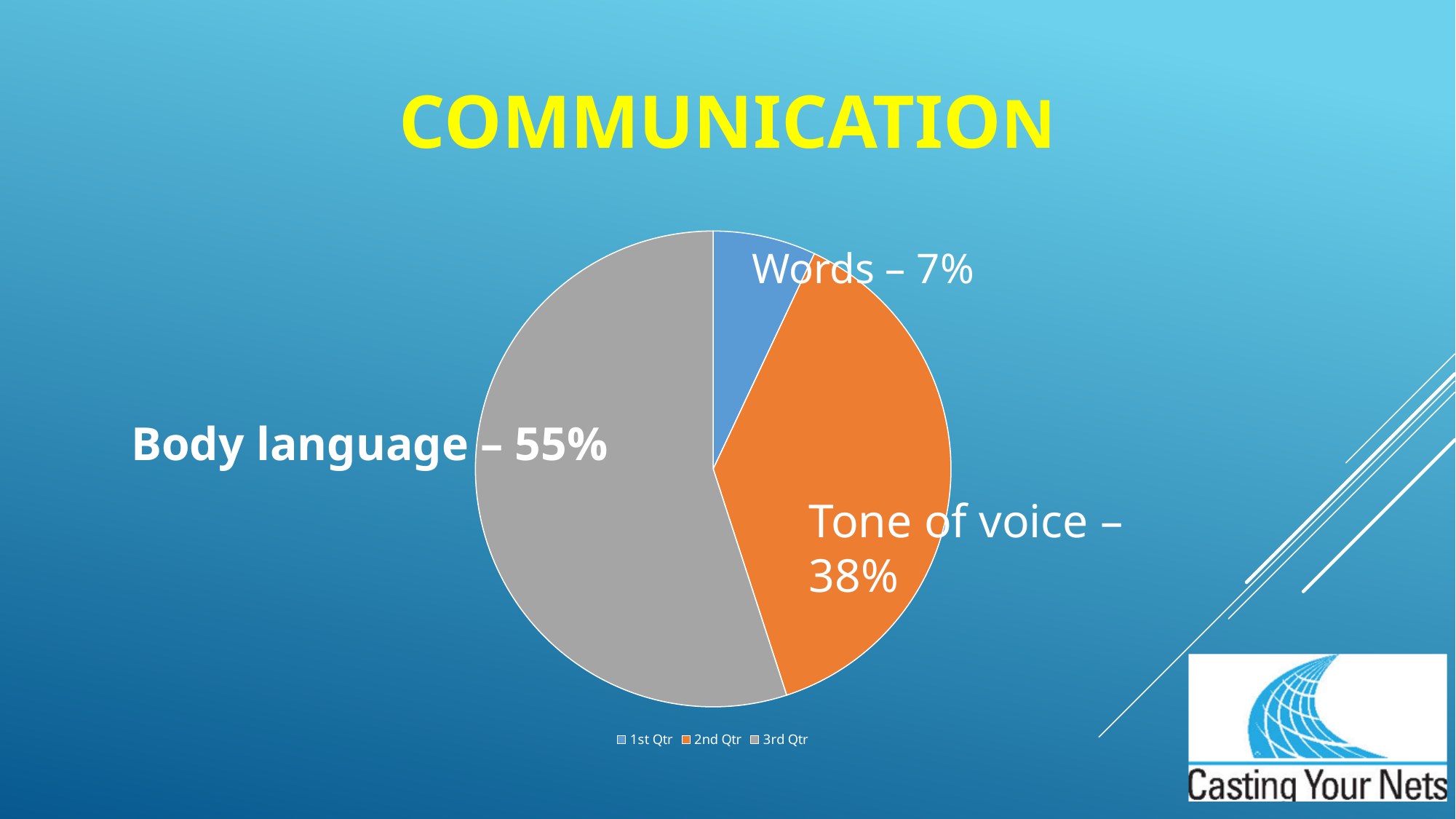
What kind of chart is shown on the slide? pie chart What percentage is shown for Body language? 55% What is the difference in percentage points between Tone of voice and Words? 31 Which component has the smallest share of the pie? Words Which component has the largest share of the pie? Body language How many entries does the legend list? 3 What percentage is shown for Words? 7% Which is larger, the share for Tone of voice or the share for Words? Tone of voice What percentage is shown for Tone of voice? 38% What is the difference in percentage points between Body language and Tone of voice? 17 How many slices does the pie chart have? 3 What is the title of the slide containing the pie chart? COMMUNICATION